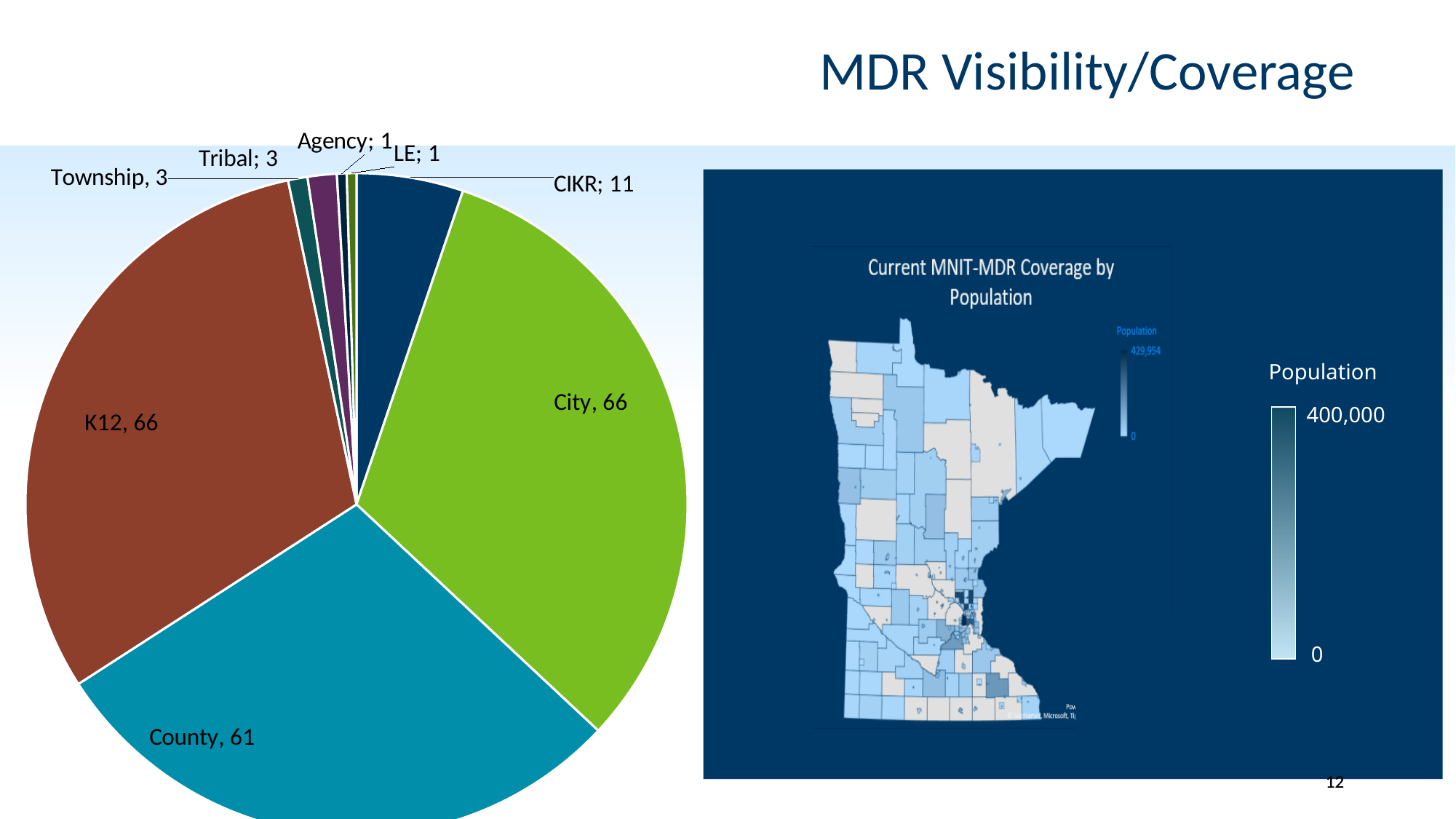
In the pie chart, which is larger, K12 or County? K12 What is the title of the map on the right of the slide? Current MNIT-MDR Coverage by Population In the pie chart, what is the value for CIKR? 11 In the pie chart, what is the difference between the City value and the County value? 5 In the pie chart, what is the difference between the CIKR value and the Tribal value? 8 In the pie chart, which is larger, County or CIKR? County In the pie chart, what is the value for County? 61 In the pie chart, what is the value for Township? 3 What is the total of all the slice values in the pie chart? 212 How many slices does the pie chart have? 8 In the pie chart, what is the value for Agency? 1 What kind of chart is shown on the left of the slide? Pie chart